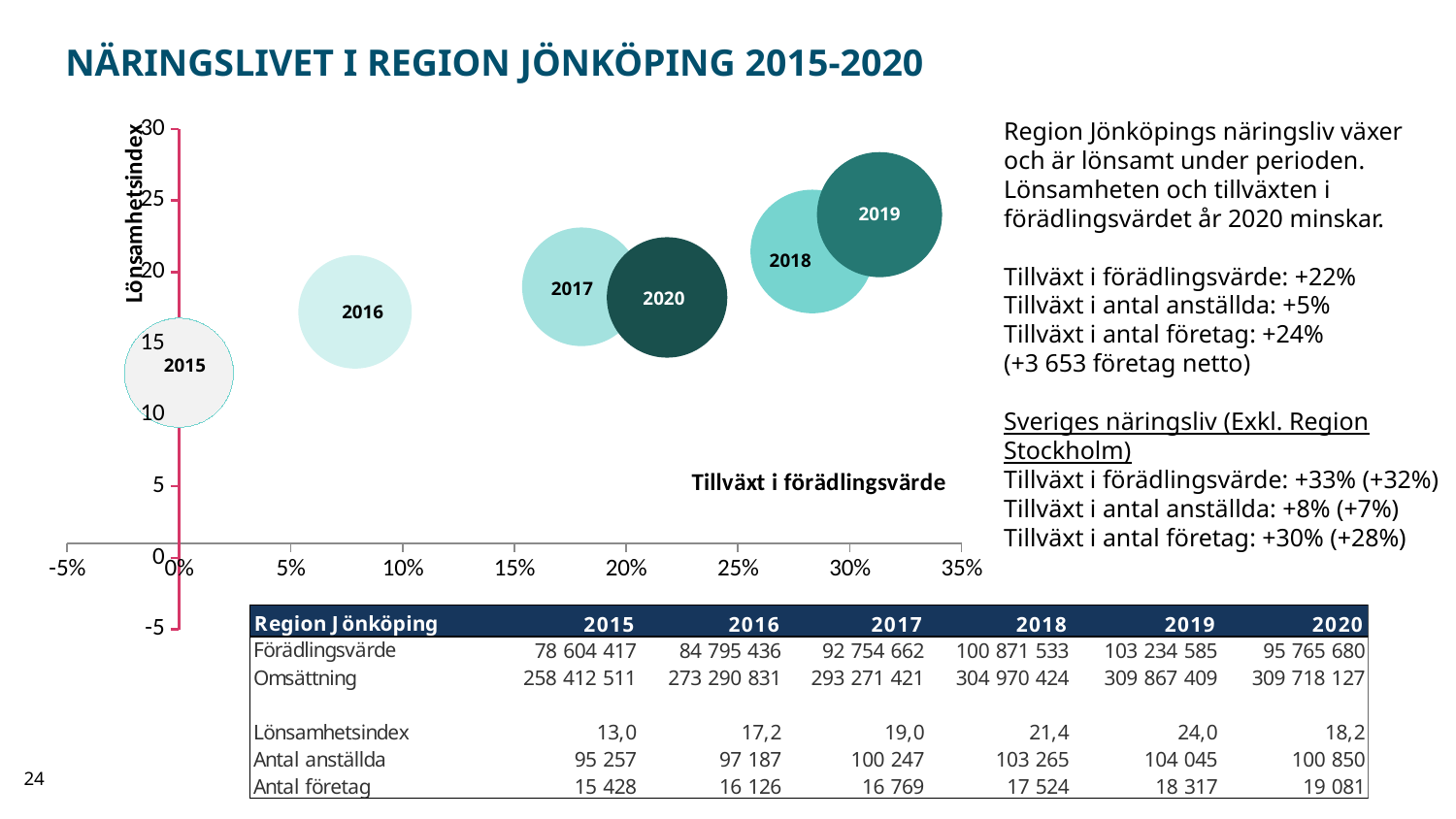
What kind of chart is shown on the slide? bubble chart Is the Tillväxt i förädlingsvärde value for the 2016 bubble greater or less than 10%? less Is the Tillväxt i förädlingsvärde value for the 2019 bubble greater or less than 25%? greater Which year has the highest Lönsamhetsindex? 2019 What is the difference in Lönsamhetsindex between 2019 and 2015? 11,0 Which year has the higher Lönsamhetsindex, 2018 or 2020? 2018 Does the Lönsamhetsindex rise or fall from 2015 to 2019? rises What is the label of the horizontal axis of the chart? Tillväxt i förädlingsvärde What is the Lönsamhetsindex value for 2019? 24,0 What is the Lönsamhetsindex value for 2020? 18,2 How many year bubbles are plotted in the chart? 6 Which year has the lowest Lönsamhetsindex? 2015